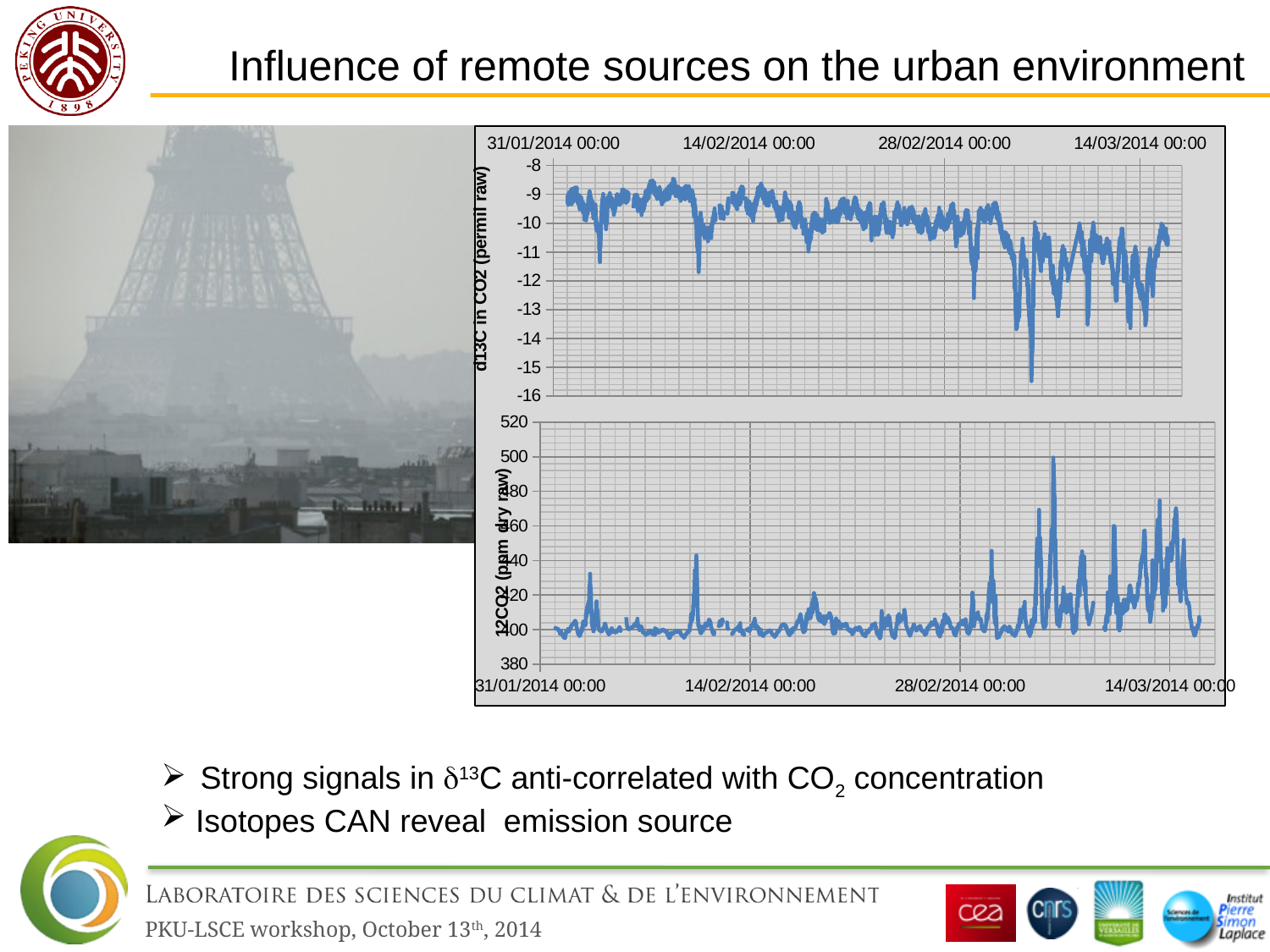
What is the y-axis label of the top chart? d13C in CO2 (permil raw) In the top chart (d13C in CO2), are the values at the start of the series (around 31/01/2014) greater or less than -10? greater What kind of chart is the top chart on the slide? line chart In the bottom chart (12CO2), do the values generally rise or fall from 31/01/2014 to 14/03/2014? rise In the bottom chart (12CO2), are the values at the start of the series (around 31/01/2014) greater or less than 420? less In the bottom chart (12CO2), is the value at 14/02/2014 00:00 greater or less than 460? less In the top chart (d13C in CO2), do the values generally rise or fall from 31/01/2014 to 14/03/2014? fall How many date ticks are labelled on the x axis of the bottom chart? 4 What is the y-axis label of the bottom chart? 12CO2 (ppm dry raw) What kind of chart is the bottom chart on the slide? line chart